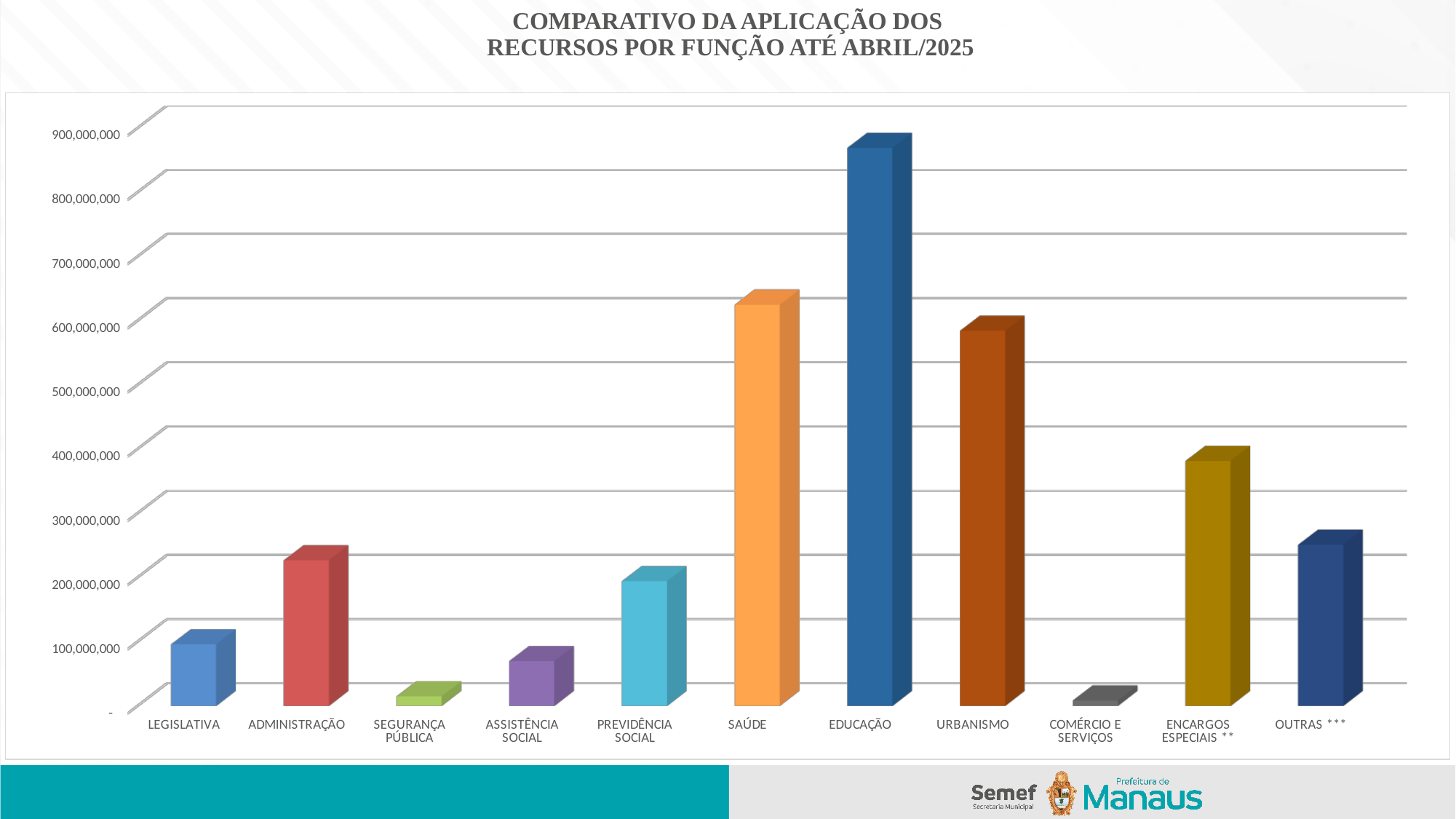
Which is larger, the value for SAÚDE or the value for URBANISMO? SAÚDE Is the value for OUTRAS *** greater or less than 200,000,000? greater Which function has the lowest value in the chart? COMÉRCIO E SERVIÇOS How many categories (functions) are shown on the x axis of the chart? 11 Is the value for SAÚDE greater or less than 500,000,000? greater What is the title of the chart? COMPARATIVO DA APLICAÇÃO DOS RECURSOS POR FUNÇÃO ATÉ ABRIL/2025 What kind of chart is shown on the slide? bar chart Is the value for EDUCAÇÃO greater or less than 800,000,000? greater Which function has the highest value in the chart? EDUCAÇÃO Which is larger, the value for ENCARGOS ESPECIAIS ** or the value for OUTRAS ***? ENCARGOS ESPECIAIS **